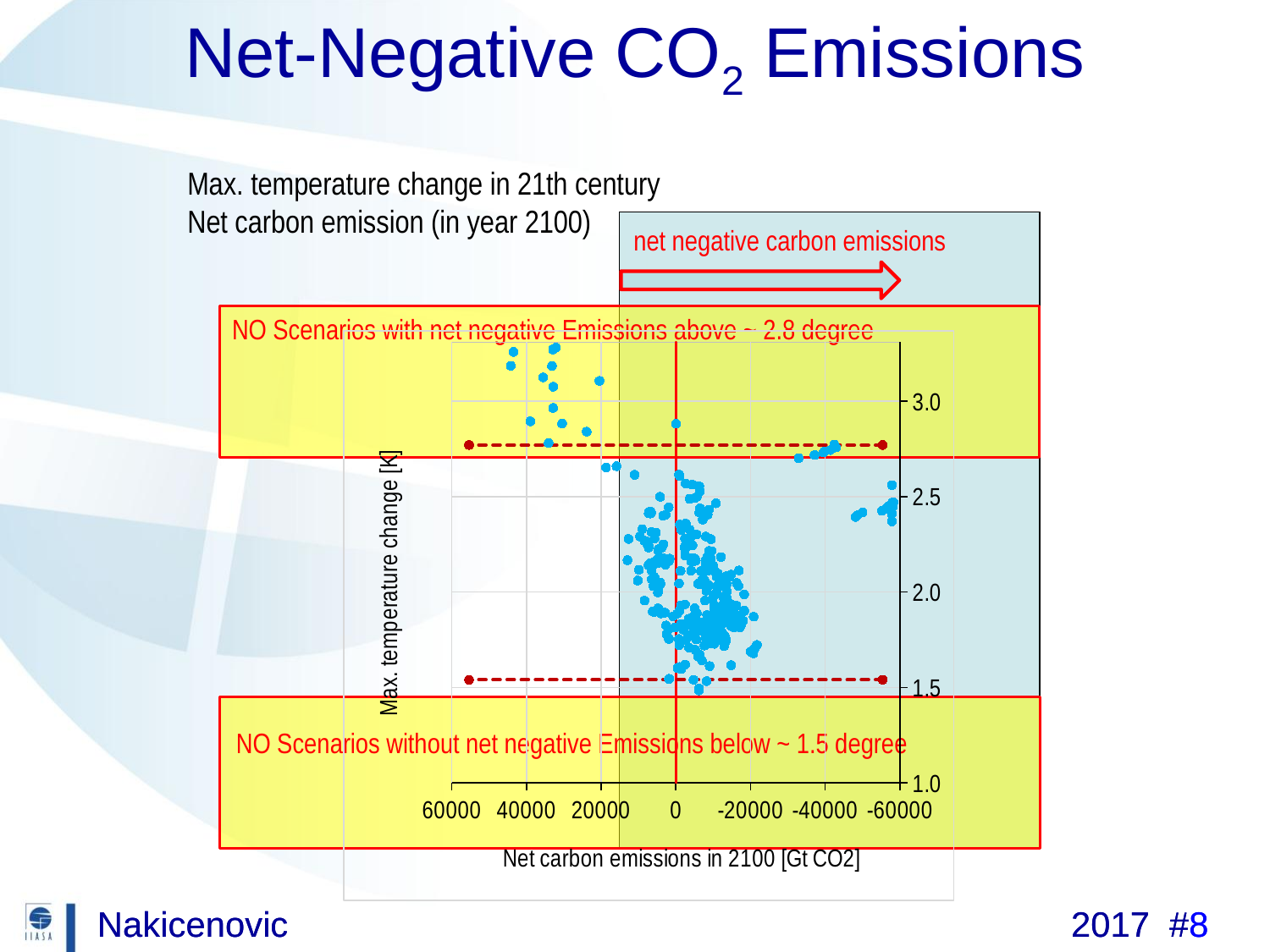
What kind of chart is shown on the slide? scatter chart Are there any plotted points with net carbon emissions of 0 or more and a temperature change below 1.5? no Moving along the x axis from positive net carbon emissions (left) to negative net carbon emissions (right), do the plotted temperature change values generally rise or fall? fall Do the points with positive net carbon emissions generally have higher or lower temperature change than the points with negative net carbon emissions? higher What is the label of the vertical axis of the chart? Max. temperature change [K] What is the label of the horizontal axis of the chart? Net carbon emissions in 2100 [Gt CO2] Is the lowest plotted temperature change value greater or less than 2.0? less Is the highest plotted temperature change value greater or less than 3.0? greater